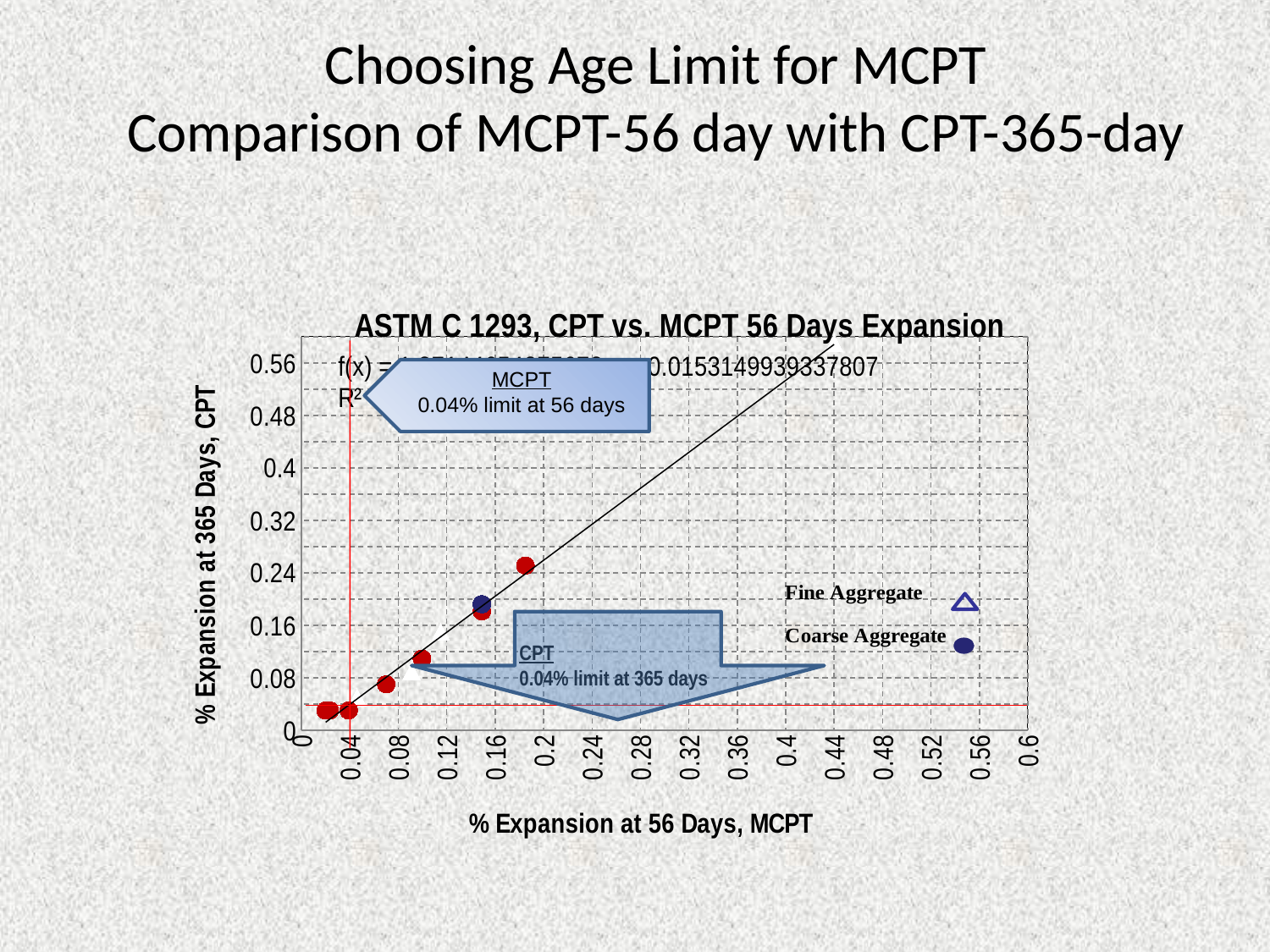
Which series has the higher plotted y value: the Coarse Aggregate point near x = 0.15 or the Fine Aggregate point near x = 0.1? Coarse Aggregate Is the highest plotted % Expansion at 365 Days, CPT value greater or less than 0.16? greater What are the two entries in the chart legend? Fine Aggregate and Coarse Aggregate Do the plotted CPT 365-day expansion values rise or fall as the MCPT 56-day expansion increases along the x axis? Rise What kind of chart is shown on the slide? Scatter chart Is the largest plotted % Expansion at 56 Days, MCPT value greater or less than 0.16? greater What is the title of the chart? ASTM C 1293, CPT vs. MCPT 56 Days Expansion Is the CPT 365-day expansion of the point plotted at about 0.1 on the x axis greater or less than 0.16? less How many series does the chart legend list? 2